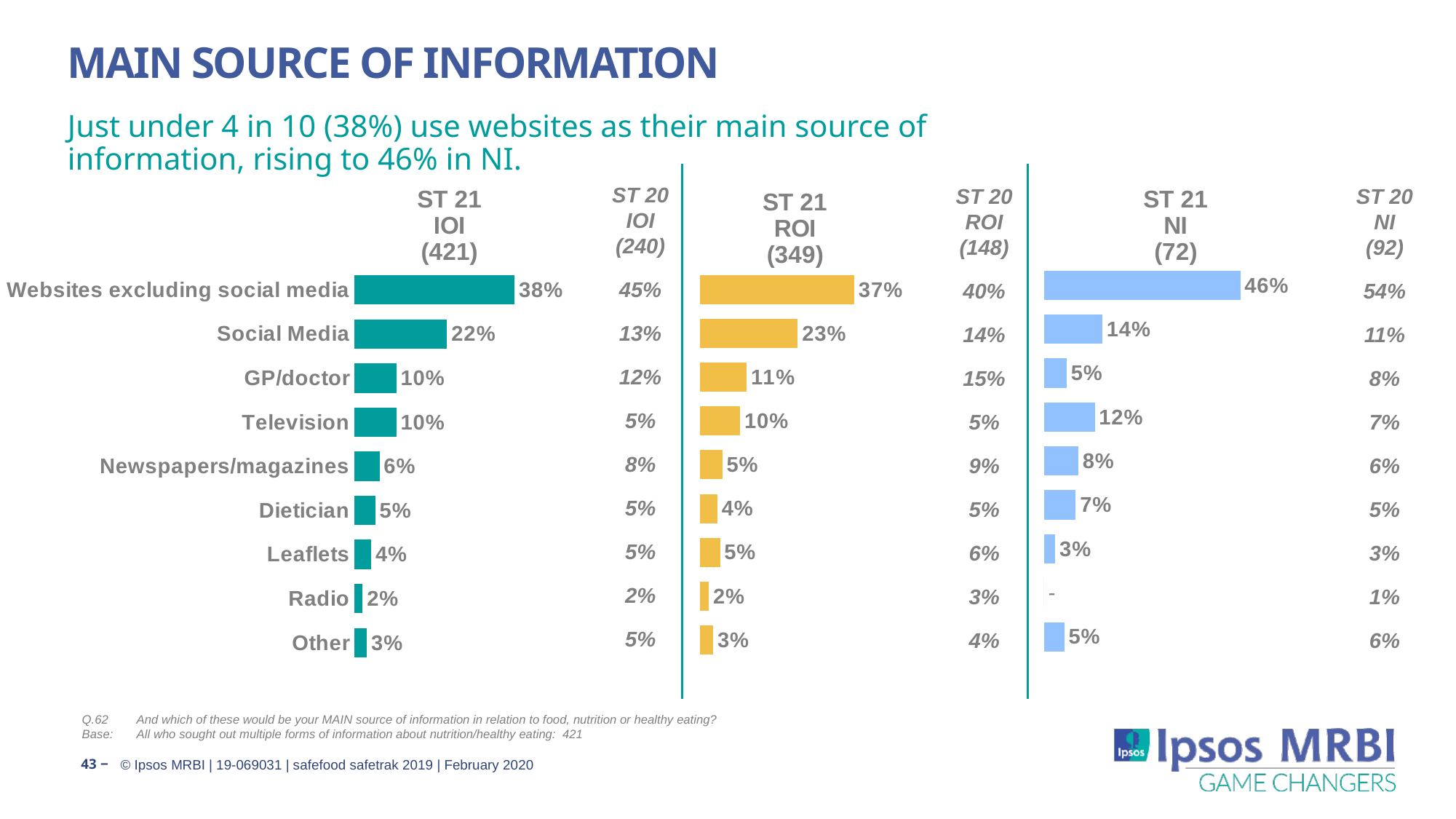
In the ST 21 NI chart, what is the difference between Websites excluding social media and Social Media? 32% In the ST 21 NI chart, what is the value for Television? 12% In the ST 21 IOI chart, what is the value for Social Media? 22% In the ST 21 IOI chart, which category has the lowest value? Radio How many categories are shown in the ST 21 IOI chart? 9 What colour are the bars in the ST 21 ROI chart? Yellow In the ST 21 NI chart, which is larger, Newspapers/magazines or GP/doctor? Newspapers/magazines What kind of chart is the ST 21 ROI chart? Bar chart In the ST 21 ROI chart, what is the value for Websites excluding social media? 37% In the ST 21 IOI chart, what is the difference between Websites excluding social media and Social Media? 16% In the ST 21 ROI chart, which is larger, GP/doctor or Television? GP/doctor In the ST 21 NI chart, which category has the highest value? Websites excluding social media